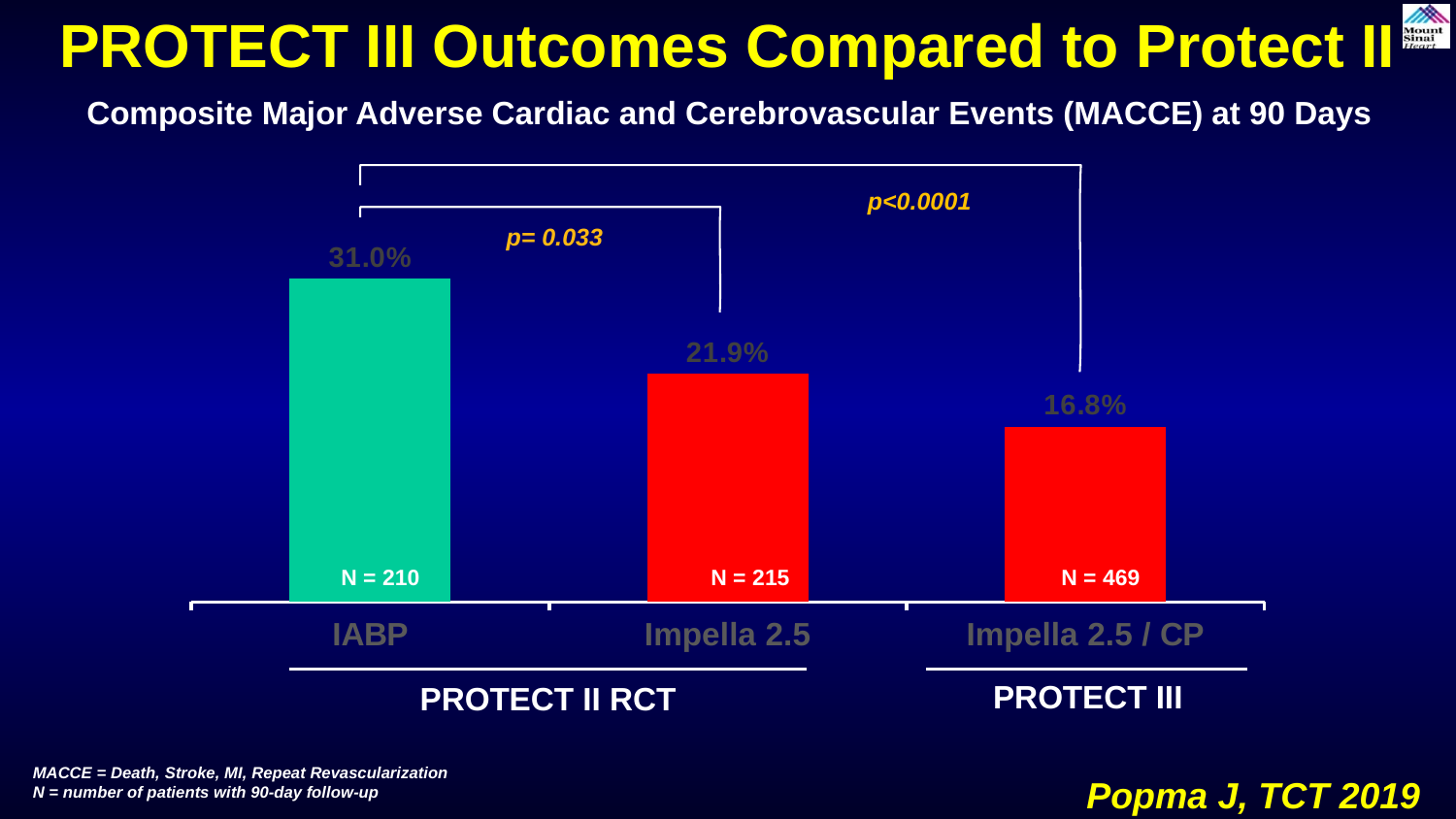
What type of chart is shown on the slide? Bar chart Which group has a higher MACCE rate, Impella 2.5 or Impella 2.5 / CP? Impella 2.5 How many groups are shown in the chart? 3 What is the MACCE rate at 90 days for the Impella 2.5 group? 21.9% How many patients (N) are in the Impella 2.5 / CP group? 469 What is the difference in MACCE rate between the IABP and Impella 2.5 / CP groups? 14.2% Which group has the lowest MACCE rate? Impella 2.5 / CP Which group has the highest MACCE rate? IABP What is the difference in MACCE rate between the IABP and Impella 2.5 groups? 9.1% What is the MACCE rate at 90 days for the IABP group? 31.0% What is the MACCE rate at 90 days for the Impella 2.5 / CP group? 16.8% What p-value is shown for the comparison between IABP and Impella 2.5? p= 0.033